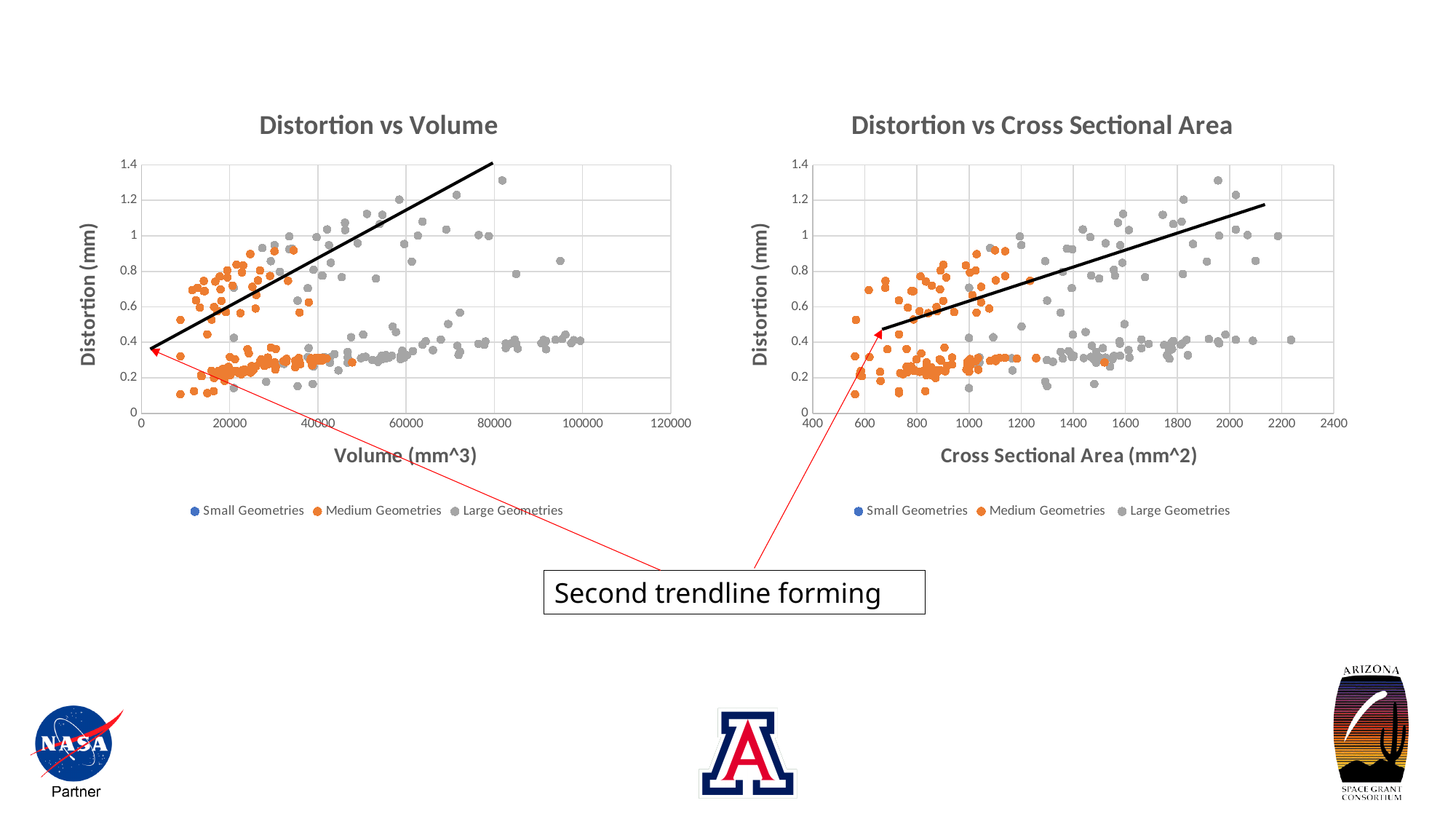
In the Distortion vs Volume chart, is the highest plotted distortion value greater or less than 1.2? greater How many series does the legend of the Distortion vs Cross Sectional Area chart list? 3 What are the legend entries of the Distortion vs Volume chart? Small Geometries, Medium Geometries, Large Geometries What is the x-axis title of the Distortion vs Cross Sectional Area chart? Cross Sectional Area (mm^2) What is the highest tick value on the x-axis of the Distortion vs Cross Sectional Area chart? 2400 In the Distortion vs Cross Sectional Area chart, does the black trendline rise or fall as cross sectional area increases? Rises What kind of chart is the Distortion vs Volume chart? Scatter chart In the Distortion vs Volume chart, does the black trendline rise or fall as volume increases? Rises In the Distortion vs Volume chart, is the lowest plotted distortion value greater or less than 0.2? less What is the highest tick value on the y-axis of the Distortion vs Volume chart? 1.4 In the Distortion vs Cross Sectional Area chart, is the highest plotted distortion value greater or less than 1.2? greater